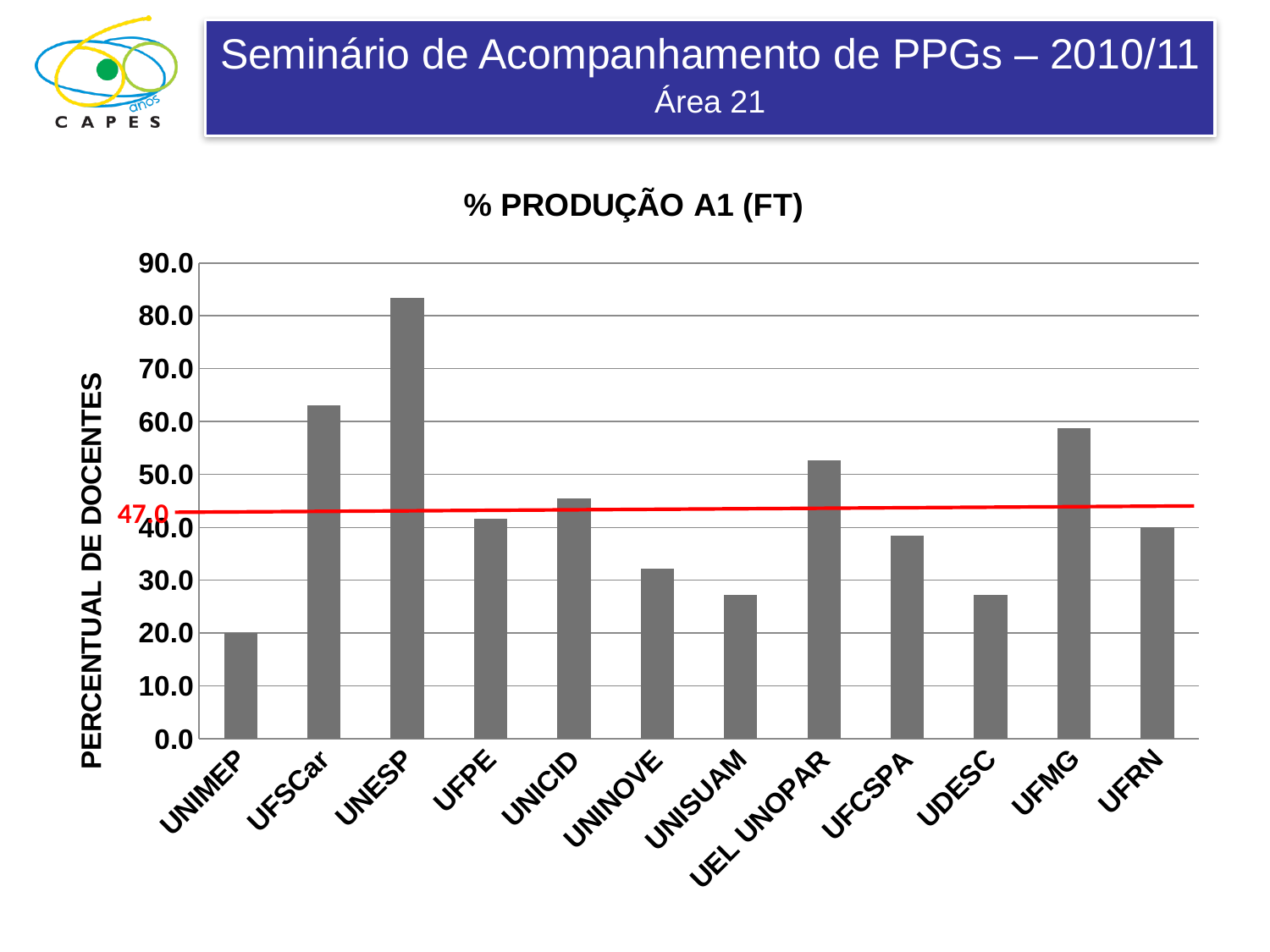
What value is labelled on the red horizontal line in the chart? 47.0 How many institutions are shown on the x axis of the chart? 12 Is the value for UFSCar greater or less than 60.0? greater Is the value for UNISUAM greater or less than 30.0? less Which institution has the lowest % PRODUÇÃO A1 (FT)? UNIMEP Which institution has the highest % PRODUÇÃO A1 (FT)? UNESP What is the title of the chart? % PRODUÇÃO A1 (FT) Is the value for UFCSPA greater or less than 40.0? less Which has a higher value, UEL UNOPAR or UFCSPA? UEL UNOPAR What kind of chart is shown on the slide? bar chart